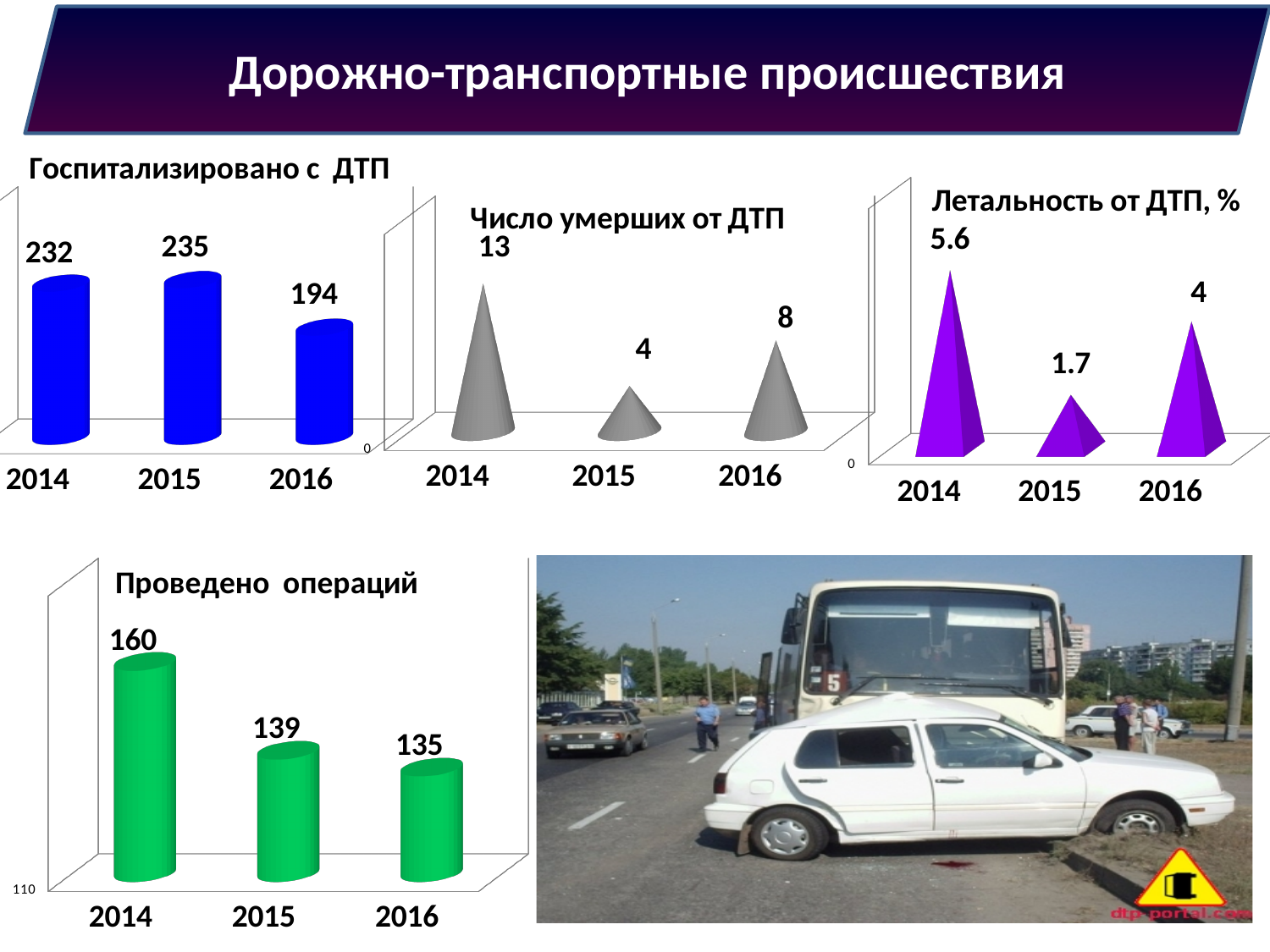
In the chart 'Летальность от ДТП, %', which is larger: the value for 2014 or the value for 2016? 2014 In the chart 'Проведено операций', what is the value for 2014? 160 In the chart 'Число умерших от ДТП', what is the difference between the values for 2014 and 2016? 5 In the chart 'Число умерших от ДТП', what is the value for 2014? 13 In the chart 'Число умерших от ДТП', which year has the lowest value? 2015 How many years are shown in the chart 'Госпитализировано с ДТП'? 3 In the chart 'Проведено операций', what is the difference between the values for 2014 and 2016? 25 In the chart 'Проведено операций', do the values rise or fall from 2014 to 2016? fall What type of chart is 'Проведено операций'? bar chart In the chart 'Госпитализировано с ДТП', which year has the highest value? 2015 In the chart 'Госпитализировано с ДТП', what is the value for 2016? 194 In the chart 'Летальность от ДТП, %', what is the value for 2015? 1.7